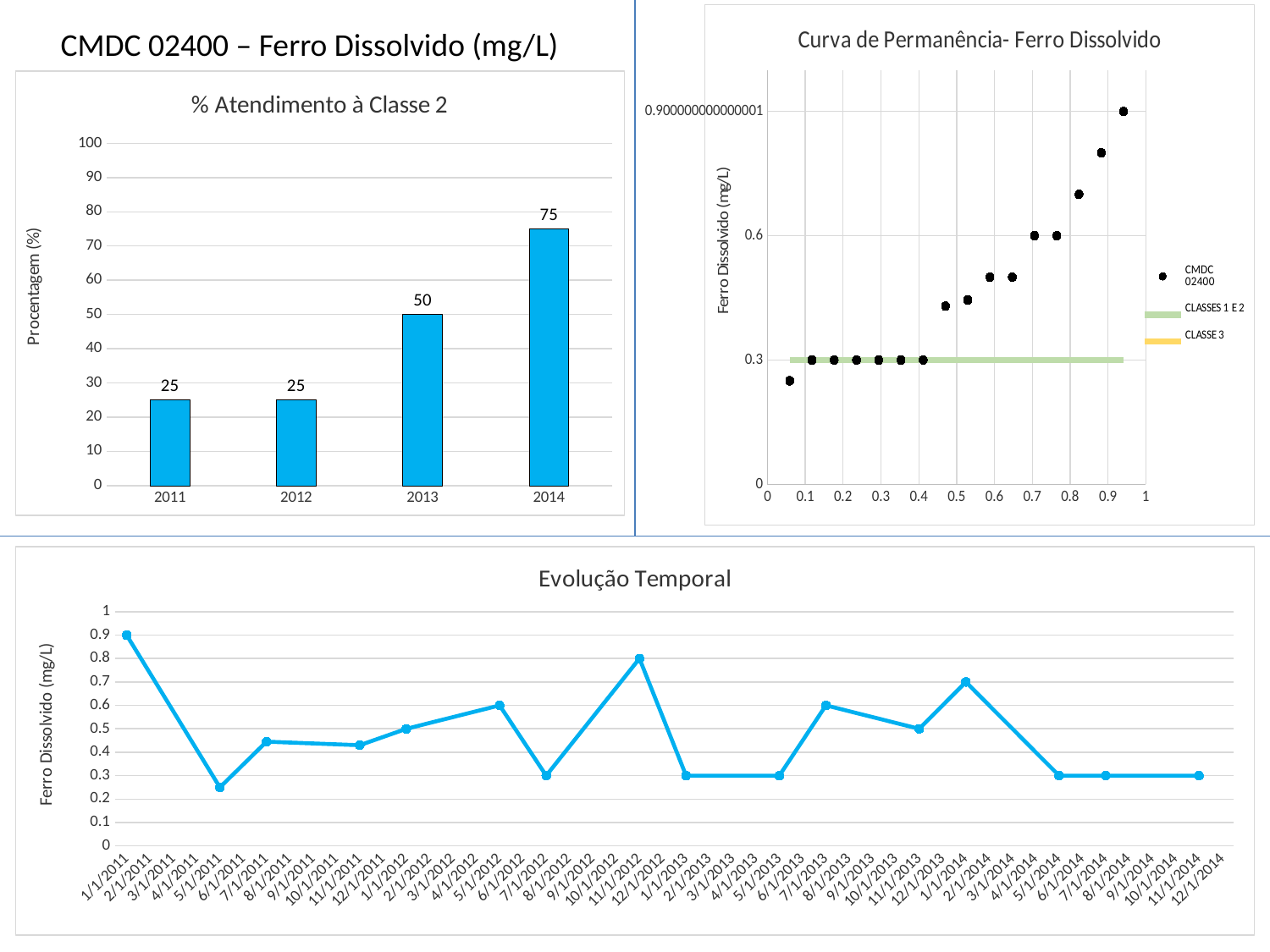
What kind of chart is '% Atendimento à Classe 2'? bar chart What kind of chart is 'Evolução Temporal'? line chart In the 'Curva de Permanência- Ferro Dissolvido' chart, what colour is the 'CLASSES 1 E 2' line? green In the '% Atendimento à Classe 2' chart, which is larger, the value for 2012 or the value for 2013? 2013 In the '% Atendimento à Classe 2' chart, what is the value for 2014? 75 How many entries does the legend of the 'Curva de Permanência- Ferro Dissolvido' chart list? 3 In the '% Atendimento à Classe 2' chart, what is the difference between the values for 2014 and 2013? 25 In the 'Evolução Temporal' chart, is the value for 1/1/2011 greater or less than 0.6? greater In the '% Atendimento à Classe 2' chart, do the values rise or fall from 2011 to 2014? rise In the '% Atendimento à Classe 2' chart, what is the value for 2013? 50 In the '% Atendimento à Classe 2' chart, which year has the highest value? 2014 How many years are shown in the '% Atendimento à Classe 2' chart? 4